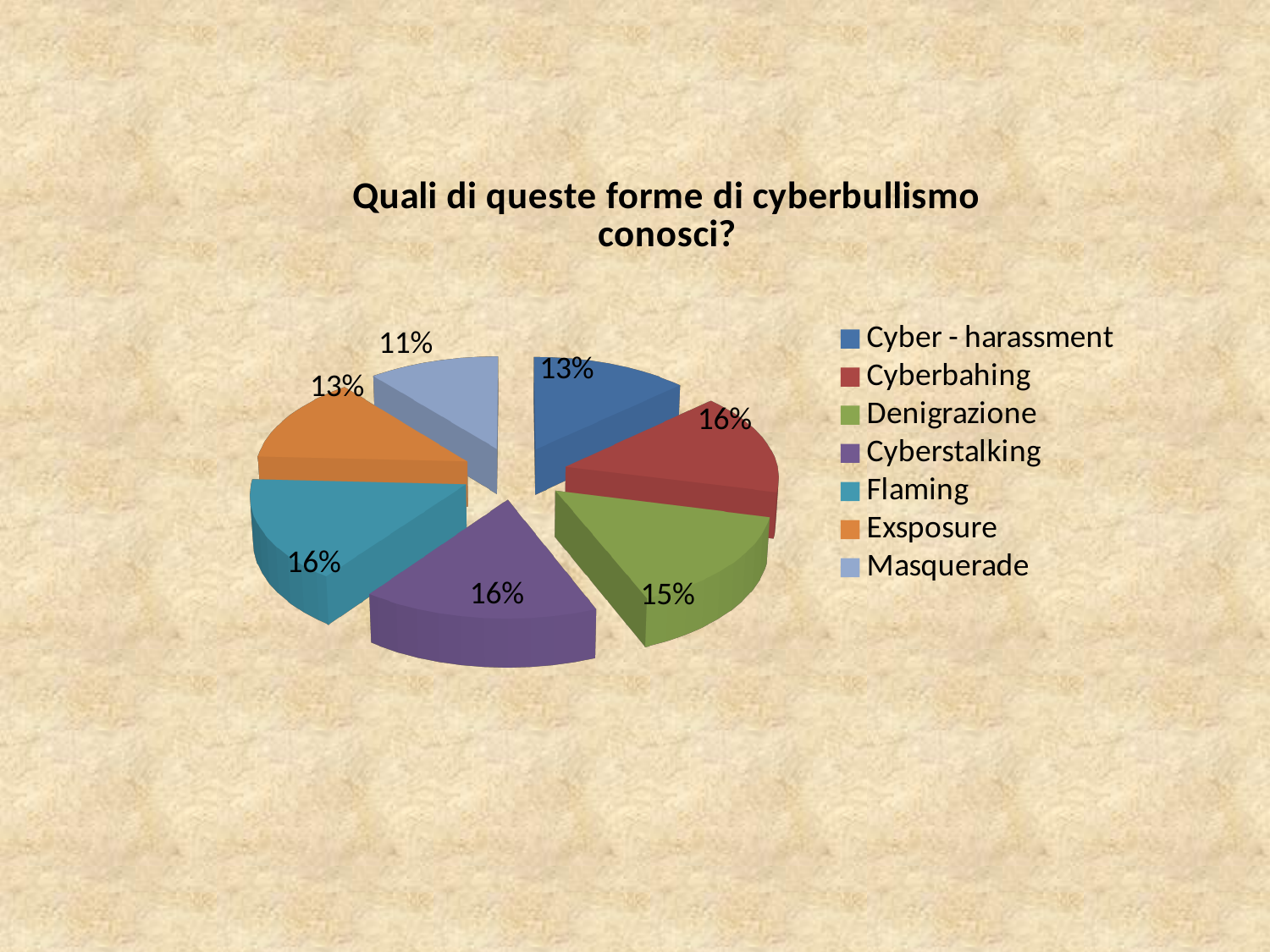
What is the title of the chart? Quali di queste forme di cyberbullismo conosci? What is the difference between the values for Cyberstalking and Masquerade? 5% What share of the pie does Masquerade have? 11% What kind of chart is shown on the slide? pie chart Which is larger, the value for Cyberbahing or the value for Denigrazione? Cyberbahing What is the value for Cyber - harassment? 13% Which colour represents Cyberstalking in the legend? purple What is the value for Exsposure? 13% What is the value for Denigrazione? 15% What is the value for Flaming? 16% How many categories does the pie chart have? 7 Which category has the smallest slice of the pie? Masquerade